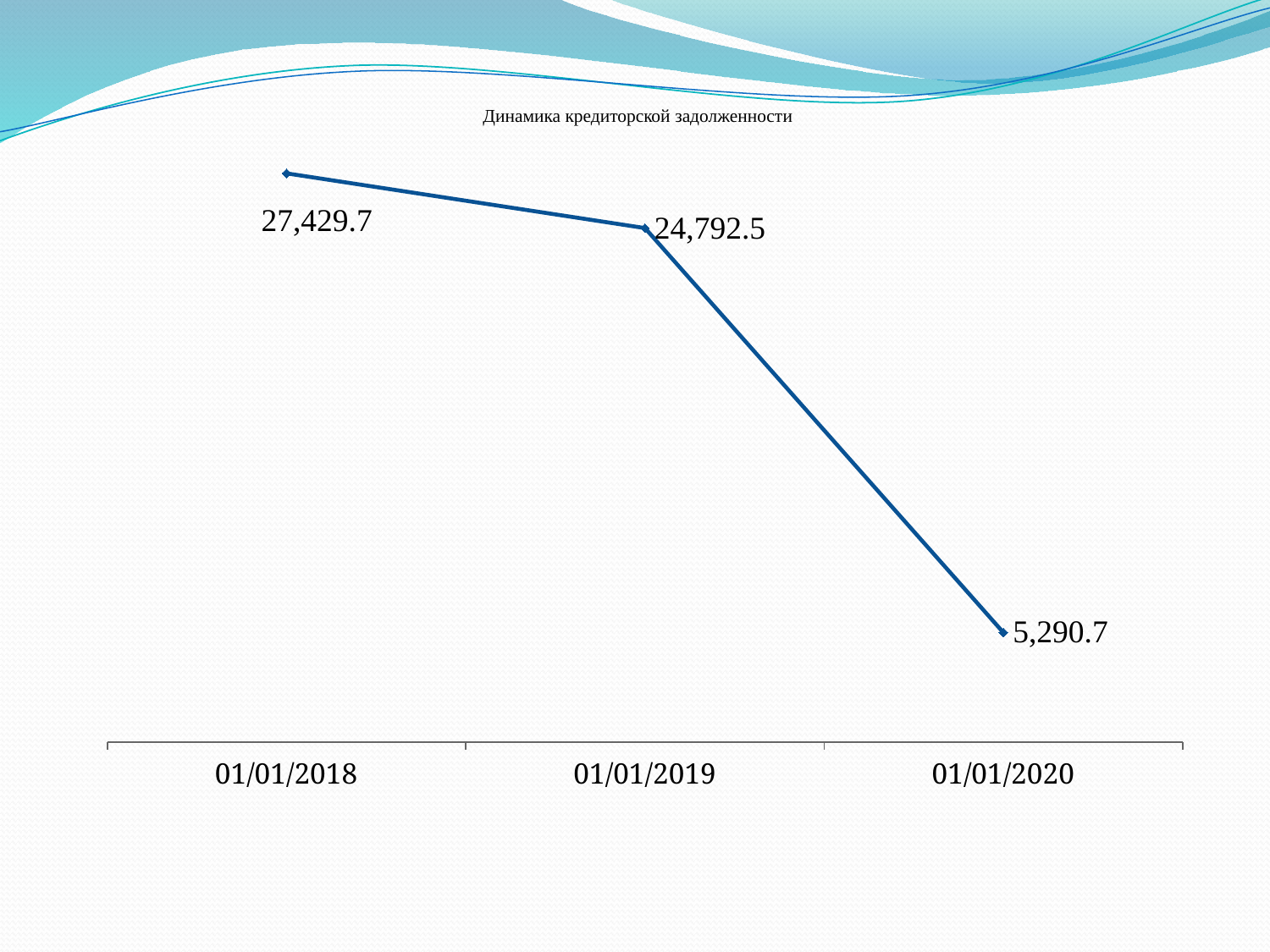
Which date has the lowest value? 01/01/2020 How many data points are plotted on the chart? 3 Do the values rise or fall from 01/01/2018 to 01/01/2020? fall What is the difference between the values for 01/01/2018 and 01/01/2019? 2,637.2 What is the title of the chart? Динамика кредиторской задолженности What kind of chart is shown on the slide? line chart Which is larger, the value for 01/01/2019 or the value for 01/01/2020? 01/01/2019 What is the value for 01/01/2020? 5,290.7 Which date has the highest value? 01/01/2018 What is the difference between the values for 01/01/2019 and 01/01/2020? 19,501.8 What is the value for 01/01/2019? 24,792.5 What is the value for 01/01/2018? 27,429.7